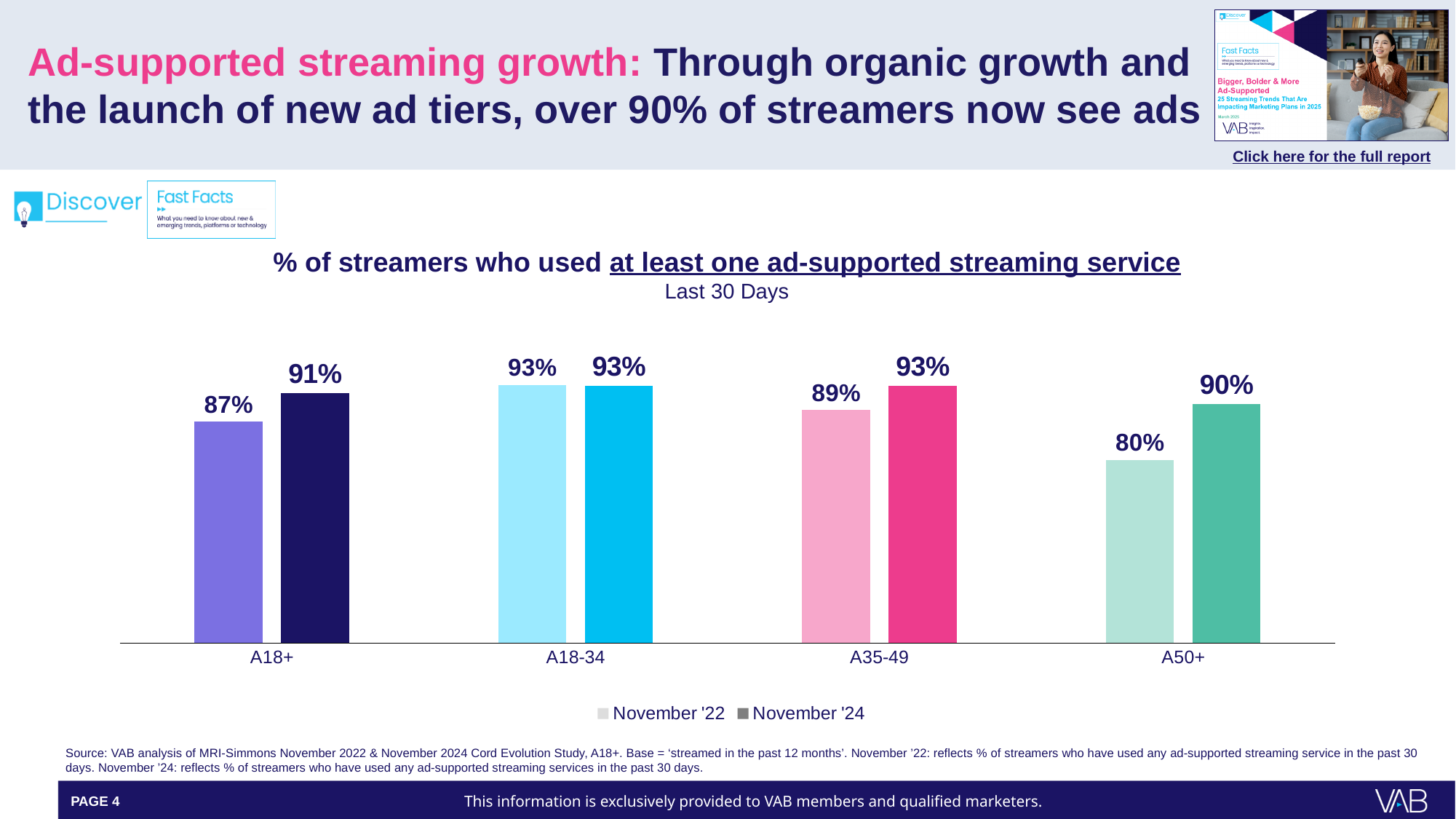
What time period is given in the chart subtitle? Last 30 Days What is the difference between the November '24 and November '22 values for A18+? 4% Which age group has the highest November '22 value? A18-34 What is the November '24 value for A18+? 91% What kind of chart is shown on the slide? Bar chart What is the November '22 value for A35-49? 89% Which age group has the lowest November '22 value? A50+ How many age groups are shown on the x axis? 4 How many series does the legend list? 2 What is the November '22 value for A50+? 80% Which is larger for A35-49: the November '22 value or the November '24 value? November '24 What is the difference between the November '24 and November '22 values for A50+? 10%